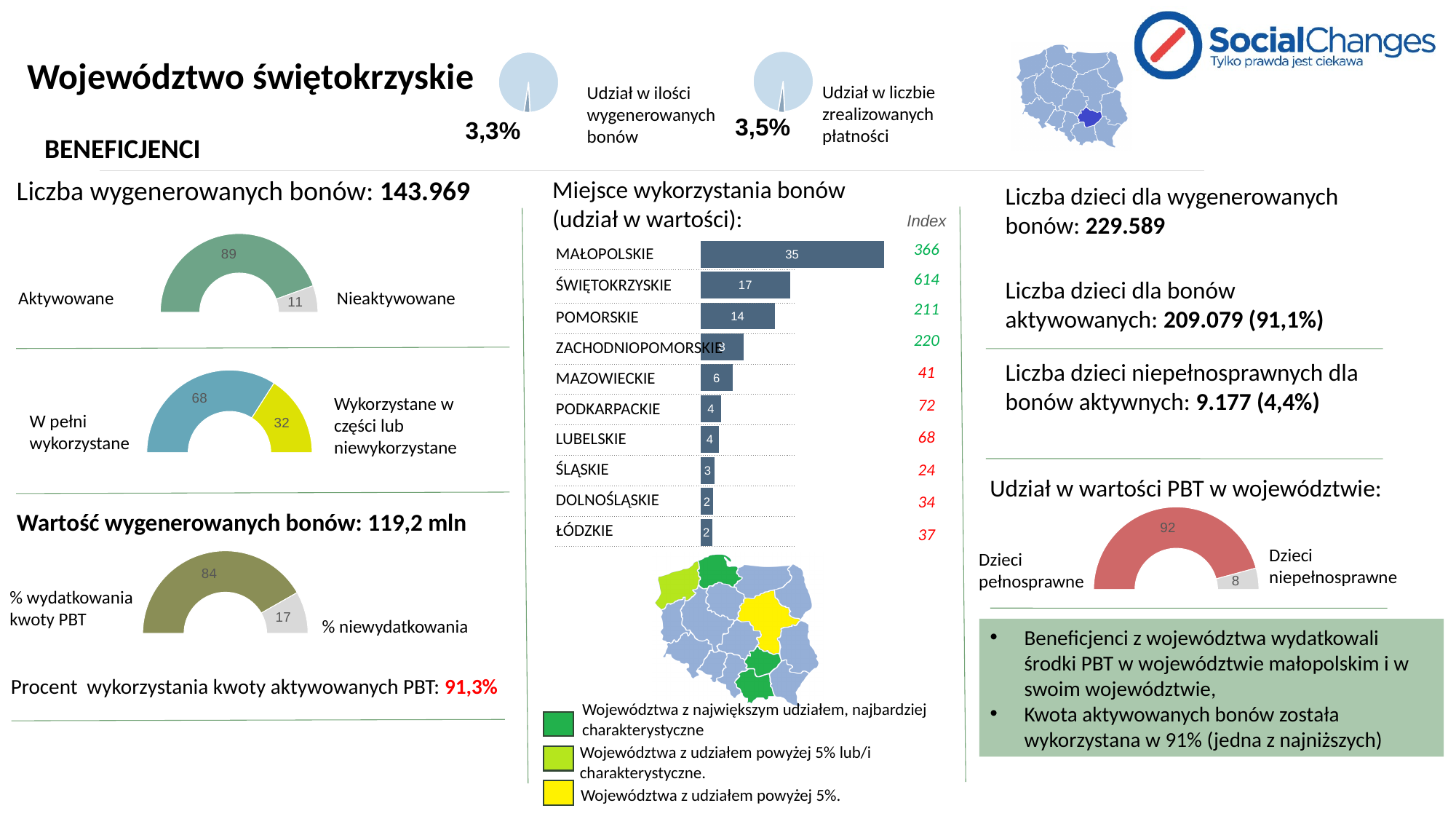
What kind of chart is 'Miejsce wykorzystania bonów (udział w wartości)'? bar chart In the 'Miejsce wykorzystania bonów (udział w wartości)' bar chart, which is larger: the value for POMORSKIE or the value for MAZOWIECKIE? POMORSKIE In the 'Miejsce wykorzystania bonów (udział w wartości)' bar chart, what is the value for ŚWIĘTOKRZYSKIE? 17 In the 'Miejsce wykorzystania bonów' chart, what is the Index value shown for ŚWIĘTOKRZYSKIE? 614 In the 'Miejsce wykorzystania bonów (udział w wartości)' bar chart, what is the value for MAŁOPOLSKIE? 35 In the half-donut chart under 'Wartość wygenerowanych bonów', what is the value for '% niewydatkowania'? 17 In the 'Udział w wartości PBT w województwie' half-donut chart, what is the value for 'Dzieci niepełnosprawne'? 8 In the 'Miejsce wykorzystania bonów (udział w wartości)' bar chart, what is the difference between the values for MAŁOPOLSKIE and POMORSKIE? 21 In the half-donut chart under 'Liczba wygenerowanych bonów', what is the value for Aktywowane? 89 In the half-donut chart with 'W pełni wykorzystane', what is the value for 'Wykorzystane w części lub niewykorzystane'? 32 In the 'Miejsce wykorzystania bonów (udział w wartości)' bar chart, which region has the highest value? MAŁOPOLSKIE How many regions are listed in the 'Miejsce wykorzystania bonów (udział w wartości)' bar chart? 10